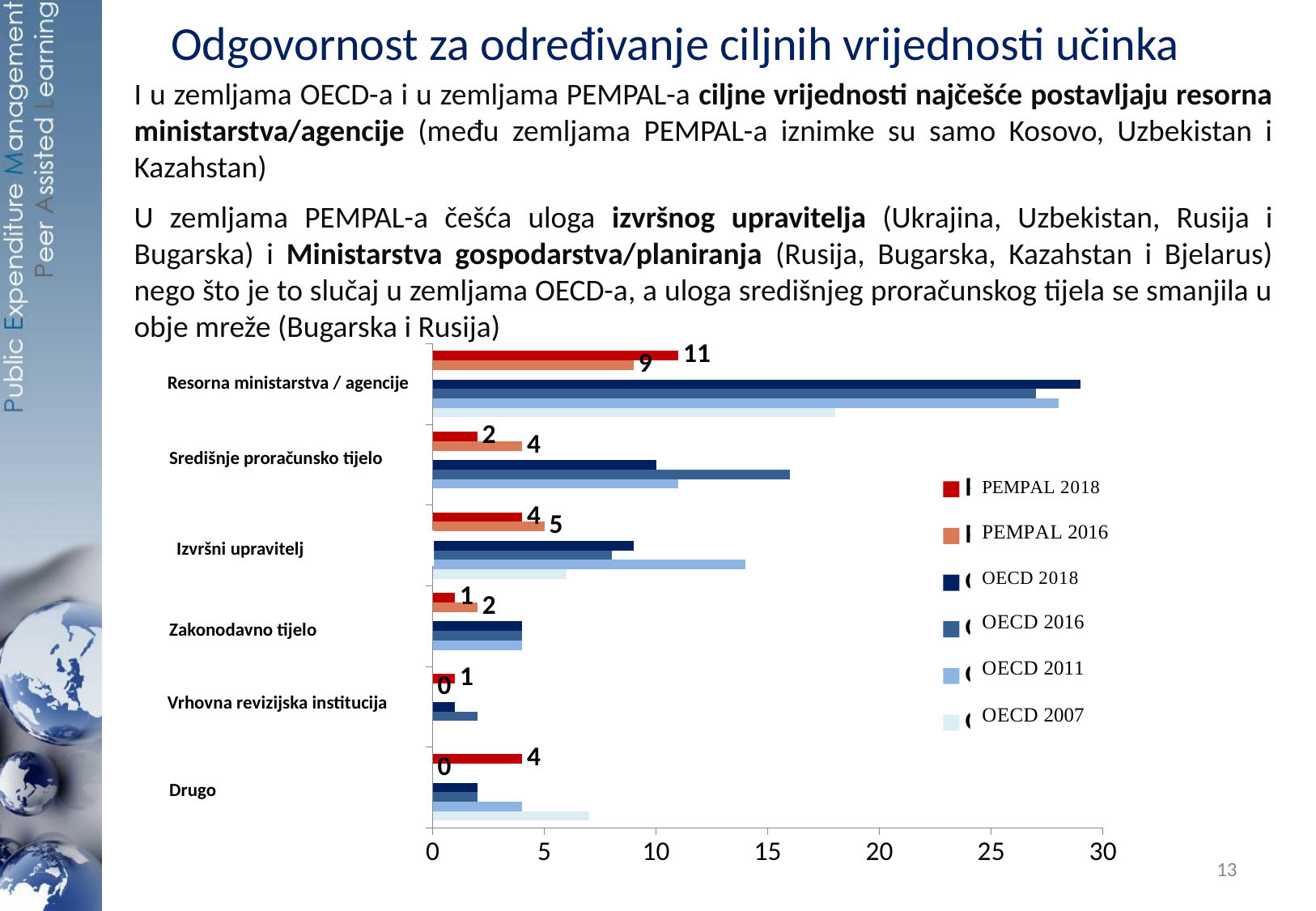
What is the difference between the PEMPAL 2018 and PEMPAL 2016 values for Resorna ministarstva / agencije? 2 Is the OECD 2018 value for Resorna ministarstva / agencije greater or less than 25? greater Is the OECD 2011 value for Izvršni upravitelj greater or less than 10? greater What is the PEMPAL 2018 value for Resorna ministarstva / agencije? 11 What is the PEMPAL 2016 value for Izvršni upravitelj? 5 What is the PEMPAL 2018 value for Drugo? 4 What type of chart is shown on the slide? bar chart How many categories are shown on the vertical axis of the chart? 6 Which category has the highest PEMPAL 2018 value? Resorna ministarstva / agencije For Središnje proračunsko tijelo, which is larger: the PEMPAL 2018 value or the PEMPAL 2016 value? PEMPAL 2016 Which category has the lowest PEMPAL 2016 value? Drugo and Vrhovna revizijska institucija (both 0) How many series does the legend list? 6